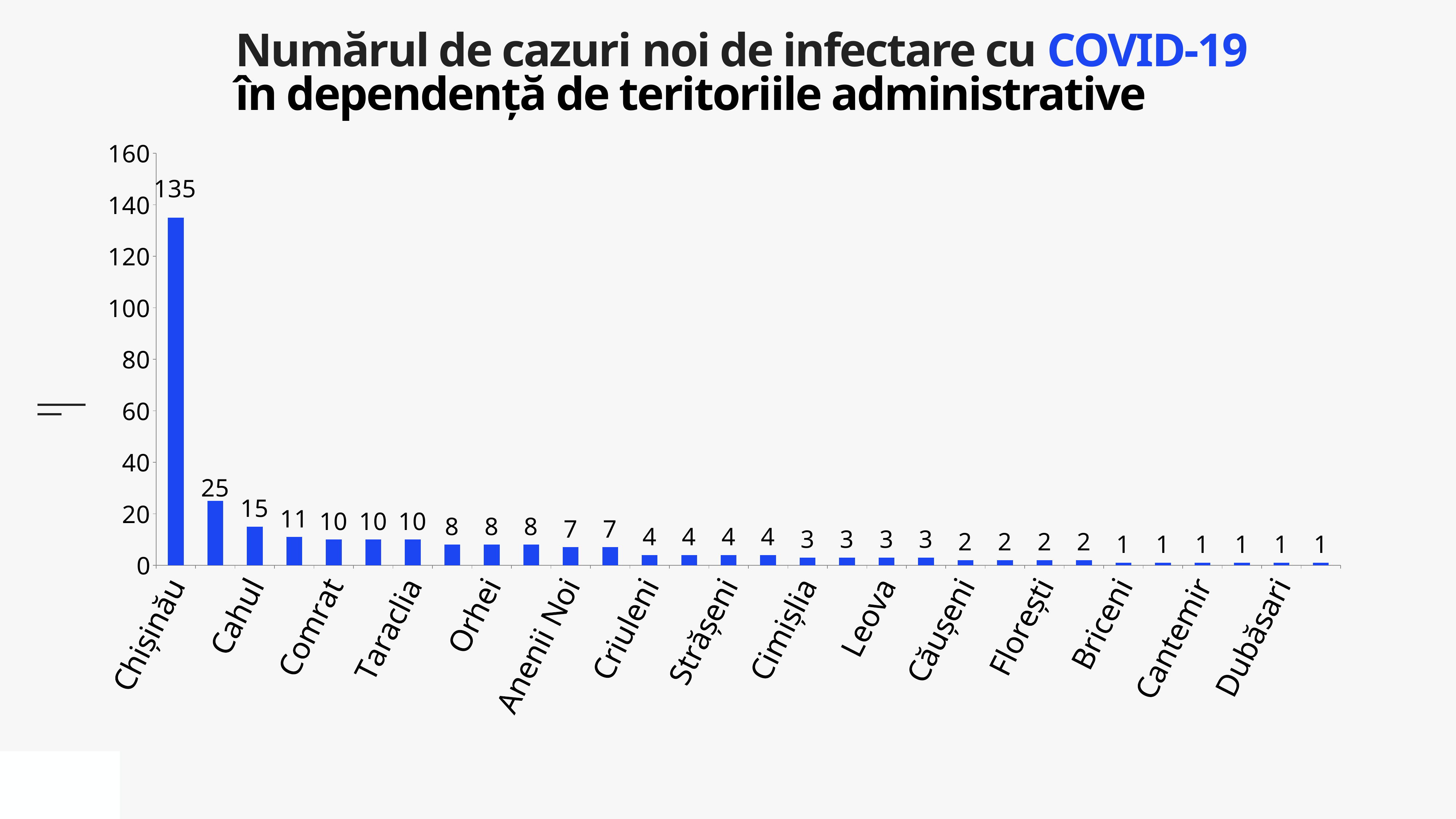
What is the highest value shown on the y axis? 160 How many bars are plotted in the chart? 30 Which is larger, the value for Chișinău or the value for Cahul? Chișinău What kind of chart is shown? bar chart Is the value for Chișinău greater or less than 120? greater Which category has the highest value? Chișinău Which is larger, the value for Cahul or the value for Dubăsari? Cahul Do the values rise or fall from left to right along the x axis? fall Is the value for Cahul greater or less than 40? less What is the value for Chișinău? 135 What colour are the bars? blue